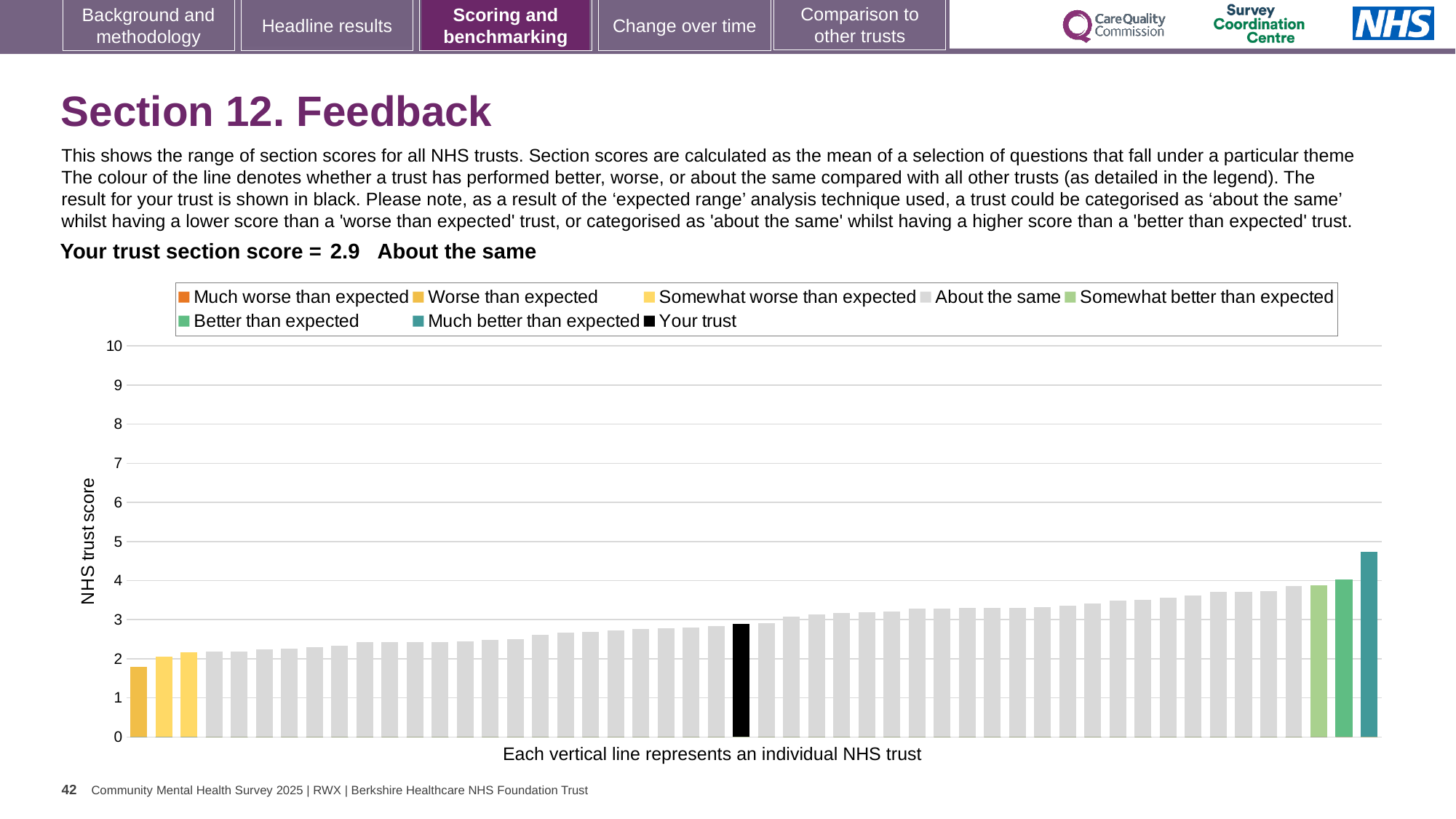
What kind of chart is shown on the slide? Bar chart How is your trust's section score categorised compared with other trusts? About the same What is the section score for your trust shown on the slide? 2.9 Is the value of the shortest bar (leftmost) greater or less than 2? less According to the caption below the chart, what does each vertical line represent? An individual NHS trust Which is larger: the value for your trust (black bar) or the value of the leftmost bar? Your trust (black bar) Do the bar values rise or fall from left to right along the x axis? Rise How many entries does the chart legend list? 8 Is the value of the tallest bar greater or less than 4? greater Is the value of the tallest bar greater or less than 5? less What is the label on the vertical axis of the chart? NHS trust score